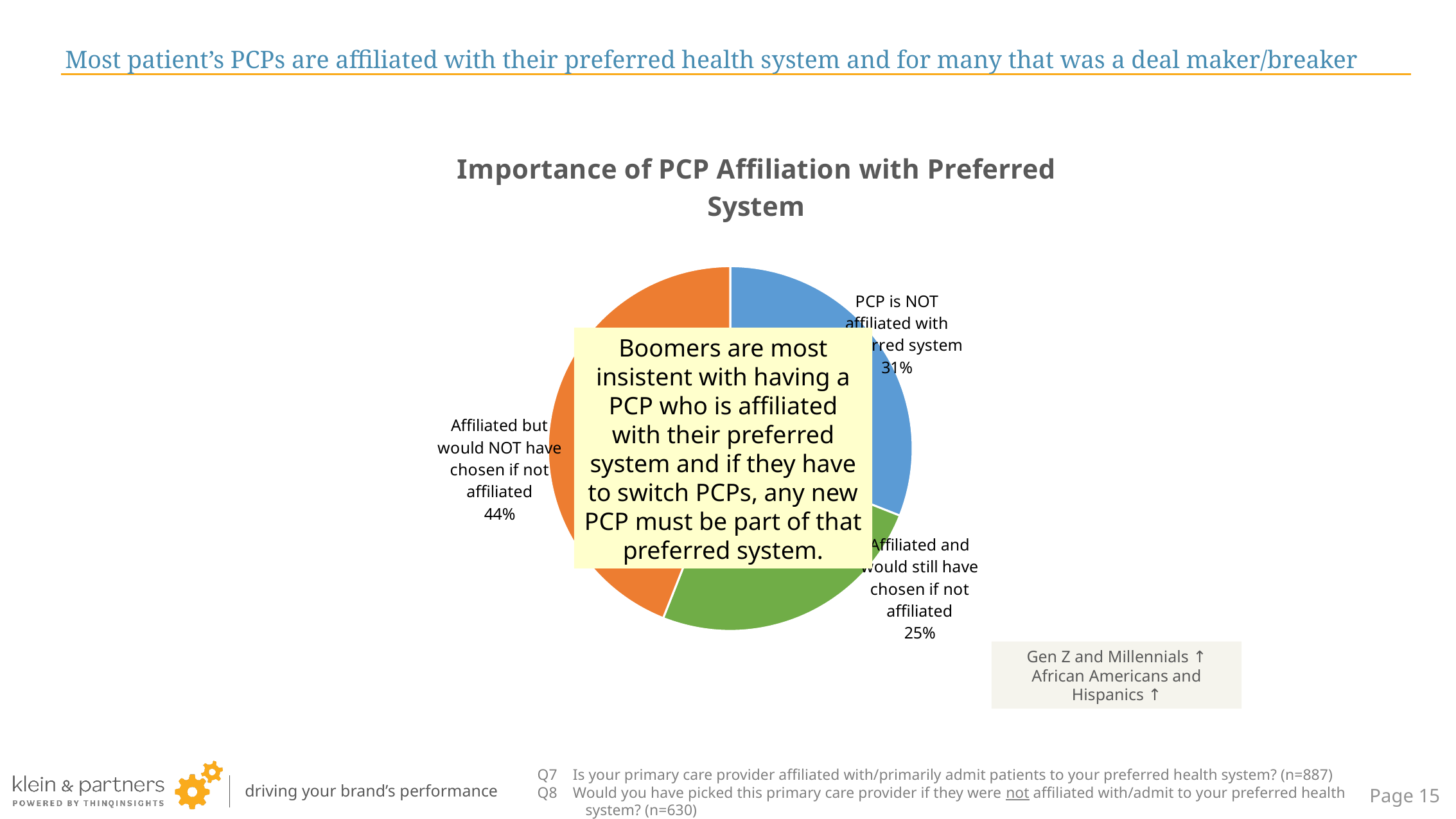
What is the difference in percentage points between 'Affiliated but would NOT have chosen if not affiliated' and 'Affiliated and would still have chosen if not affiliated'? 19 percentage points Which is larger: the share whose PCP is NOT affiliated with their preferred system, or the share who are affiliated and would still have chosen if not affiliated? PCP is NOT affiliated with preferred system What percentage of patients are 'Affiliated but would NOT have chosen if not affiliated'? 44% What colour is the slice for 'Affiliated but would NOT have chosen if not affiliated'? Orange What type of chart is shown on the slide? Pie chart What is the title of the chart? Importance of PCP Affiliation with Preferred System Which slice of the pie is the largest? Affiliated but would NOT have chosen if not affiliated What percentage of patients are 'Affiliated and would still have chosen if not affiliated'? 25% What is the difference in percentage points between 'PCP is NOT affiliated with preferred system' and 'Affiliated and would still have chosen if not affiliated'? 6 percentage points Which slice of the pie is the smallest? Affiliated and would still have chosen if not affiliated What percentage of patients say their PCP is NOT affiliated with their preferred system? 31% How many slices does the pie chart have? 3